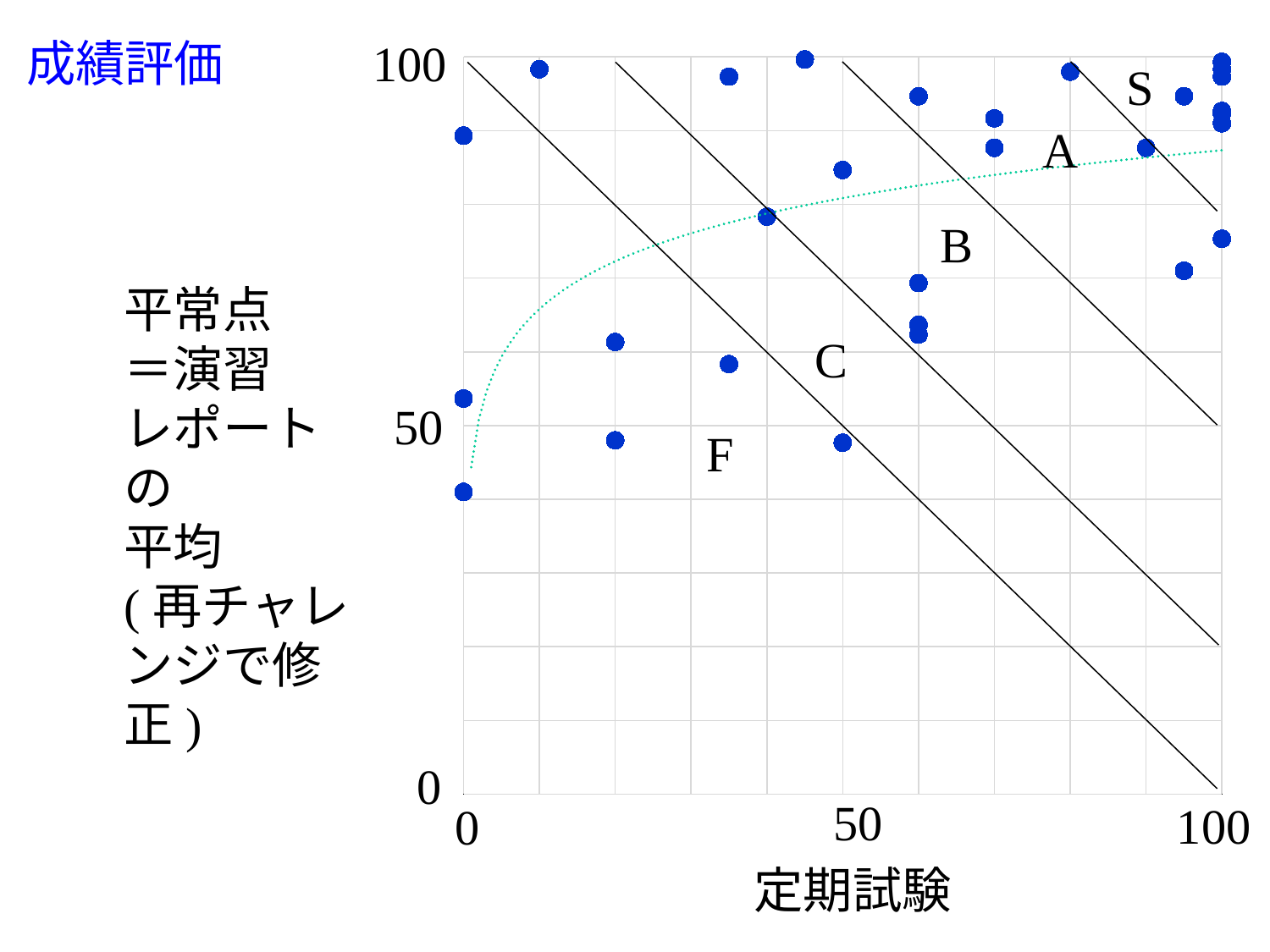
Is the y value of the lowest plotted point greater or less than 50? less What is the maximum value shown on the x axis? 100 Which grade letter is written in the top-right region of the chart? S What is the label of the x axis? 定期試験 What is the maximum value shown on the y axis? 100 Is the y value of the point plotted at x = 100 with the lowest y value greater or less than 50? greater What kind of chart is shown on the slide? scatter plot Which grade letter is written in the region below the C region? F Is the x value of the lowest plotted point greater or less than 50? less How many grade letters (S, A, B, C, F) are labelled on the chart? 5